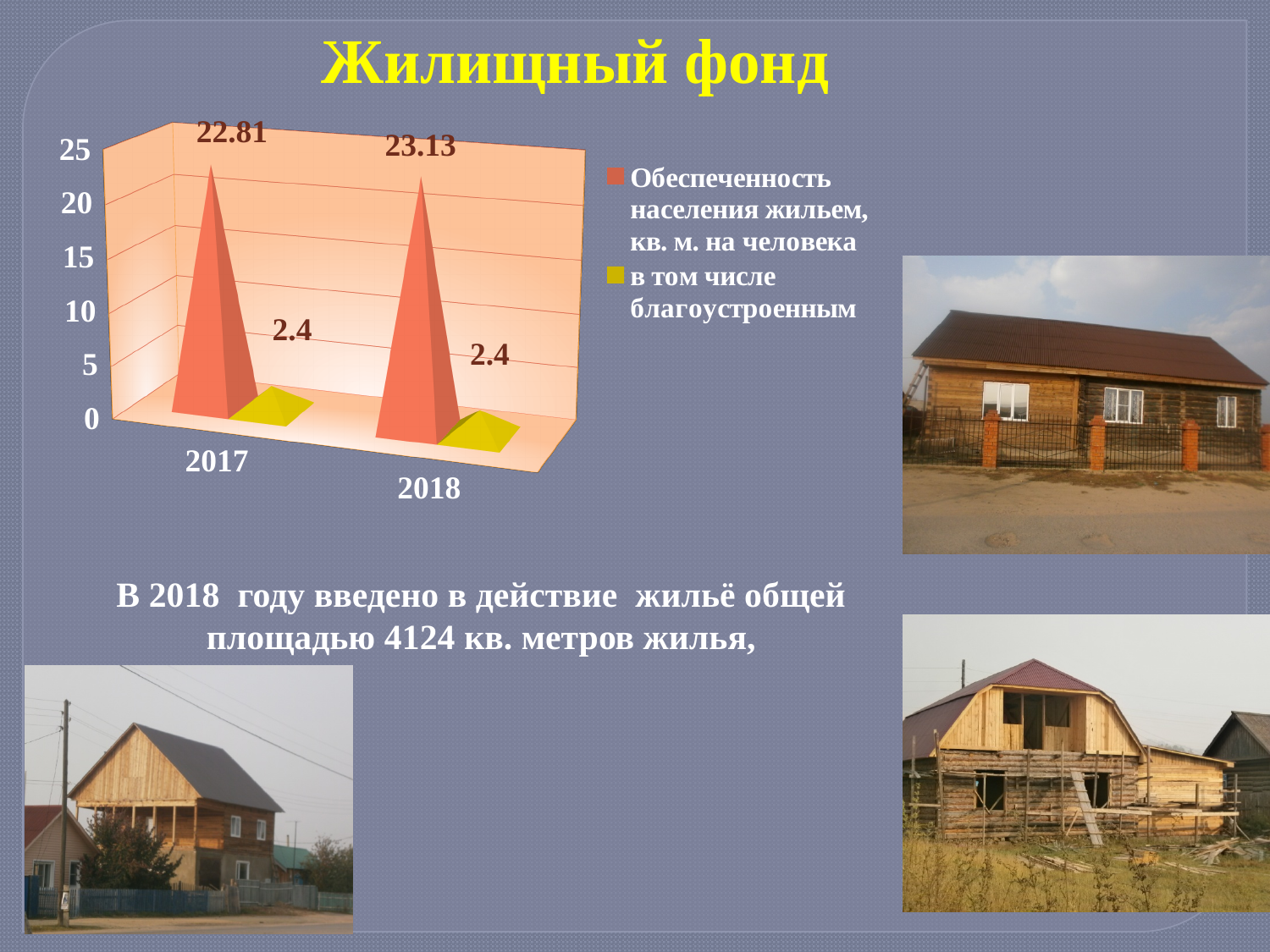
What kind of chart is shown on the slide? bar chart What is the difference between the 2018 and 2017 values of 'Обеспеченность населения жильем, кв. м. на человека'? 0.32 Does 'Обеспеченность населения жильем, кв. м. на человека' rise or fall from 2017 to 2018? rise In which year is 'Обеспеченность населения жильем, кв. м. на человека' higher? 2018 Which is larger in 2017: 'Обеспеченность населения жильем, кв. м. на человека' or 'в том числе благоустроенным'? Обеспеченность населения жильем, кв. м. на человека How many years are shown on the x axis of the chart? 2 What is the value of 'в том числе благоустроенным' for 2018? 2.4 How many series does the chart legend list? 2 What is the value of 'Обеспеченность населения жильем, кв. м. на человека' for 2017? 22.81 What is the value of 'Обеспеченность населения жильем, кв. м. на человека' for 2018? 23.13 What is the value of 'в том числе благоустроенным' for 2017? 2.4 Is the 2018 value of 'Обеспеченность населения жильем, кв. м. на человека' greater or less than 20? greater